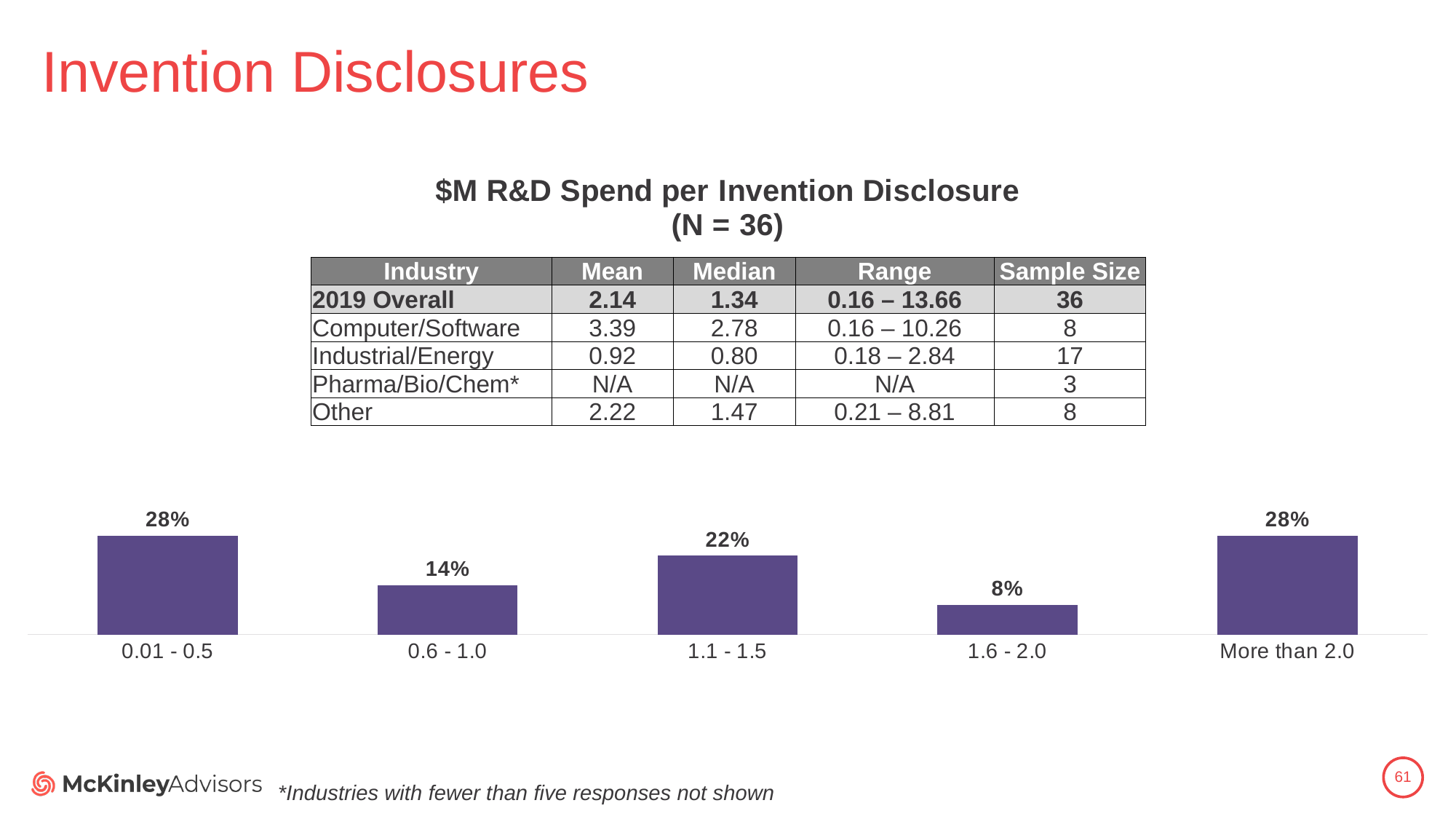
In the bar chart, does the value rise or fall from the 1.1 - 1.5 category to the 1.6 - 2.0 category? Fall What is the difference between the values for 0.01 - 0.5 and 1.6 - 2.0 in the bar chart? 20% Which category has the lowest value in the bar chart? 1.6 - 2.0 In the bar chart, which is larger: the value for 1.1 - 1.5 or the value for 0.6 - 1.0? 1.1 - 1.5 What is the value for the More than 2.0 category in the bar chart? 28% What is the value for the 0.6 - 1.0 category in the bar chart? 14% How many categories does the bar chart show? 5 What kind of chart is shown at the bottom of the slide? Bar chart What is the value for the 0.01 - 0.5 category in the bar chart? 28% What is the value for the 1.1 - 1.5 category in the bar chart? 22% What is the difference between the values for 1.1 - 1.5 and 0.6 - 1.0 in the bar chart? 8% What is the value for the 1.6 - 2.0 category in the bar chart? 8%